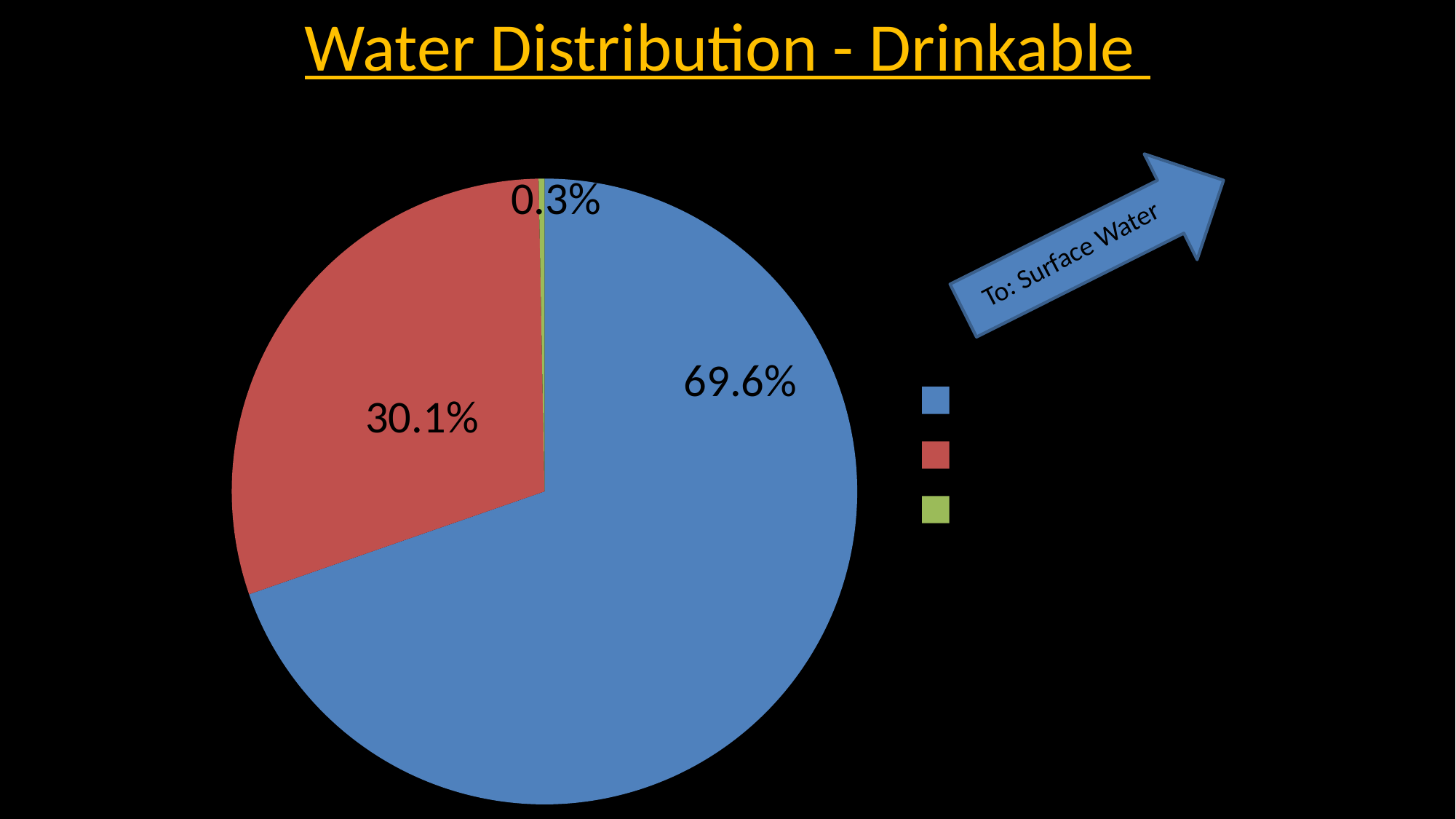
How many slices does the pie chart have? 3 What text is written on the arrow next to the pie chart? To: Surface Water What percentage is shown for the blue slice of the pie chart? 69.6% What kind of chart is shown on the slide? pie chart What percentage is shown for the green slice of the pie chart? 0.3% How many entries does the legend show? 3 Which colour slice is the largest in the pie chart? blue What is the difference in percentage points between the blue slice and the red slice? 39.5 What percentage is shown for the red slice of the pie chart? 30.1% Which is larger, the red slice or the blue slice? blue Which colour slice is the smallest in the pie chart? green What is the title of the slide? Water Distribution - Drinkable